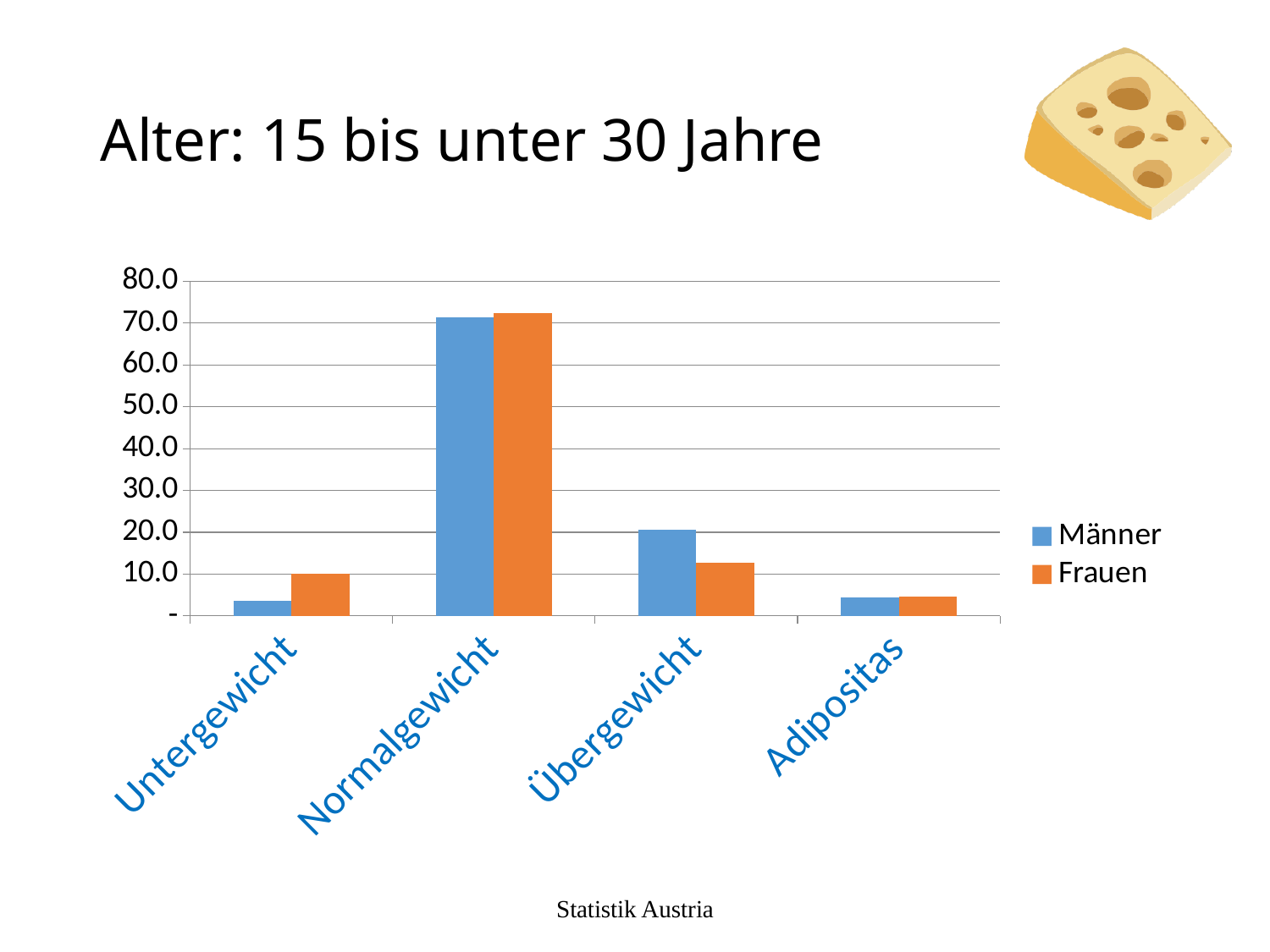
Which colour represents the Frauen series in the chart? orange For Übergewicht, which series has the larger value, Männer or Frauen? Männer What kind of chart is shown on the slide? bar chart Which category has the highest value for Männer? Normalgewicht Is the value for Frauen in Übergewicht greater or less than 20.0? less How many categories are shown on the x axis of the chart? 4 Which category has the lowest value for Männer? Untergewicht Is the value for Männer in Normalgewicht greater or less than 60.0? greater How many series does the chart legend list? 2 Which category has the lowest value for Frauen? Adipositas Which category has the highest value for Frauen? Normalgewicht For Untergewicht, which series has the larger value, Männer or Frauen? Frauen